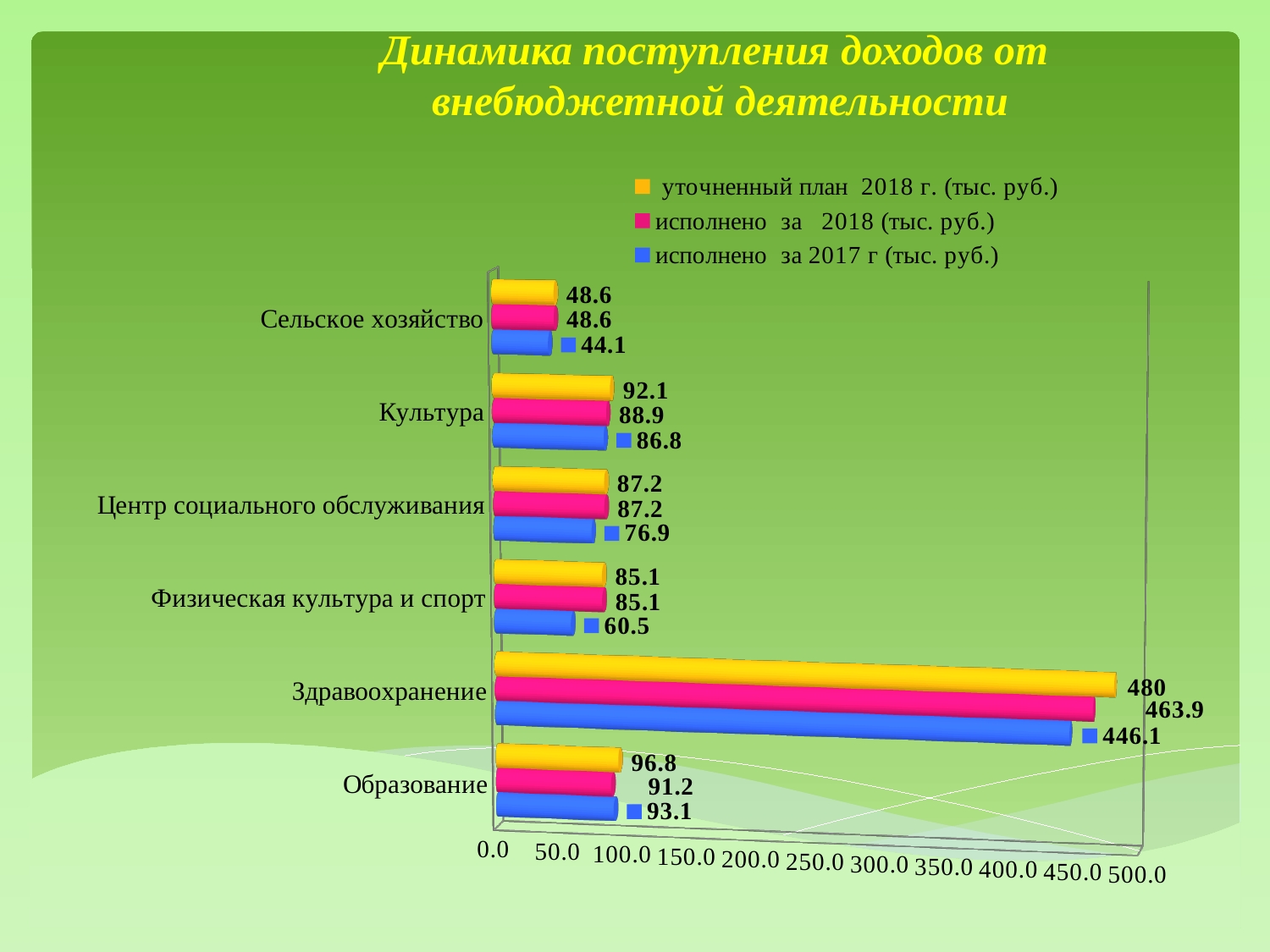
What colour represents the series 'исполнено за 2017 г (тыс. руб.)'? blue What kind of chart is shown on the slide? bar chart What is the difference between the 'уточненный план 2018 г.' and 'исполнено за 2018' values for Здравоохранение? 16.1 How many categories are shown on the chart? 6 Which category has the lowest value in the series 'исполнено за 2017 г (тыс. руб.)'? Сельское хозяйство How many series does the legend list? 3 What is the value for Культура in the series 'исполнено за 2018 (тыс. руб.)'? 88.9 What is the value for Образование in the series 'исполнено за 2017 г (тыс. руб.)'? 93.1 Is the 'исполнено за 2017 г' value for Здравоохранение greater or less than 400.0? greater Which is larger for Физическая культура и спорт: the 'исполнено за 2018' value or the 'исполнено за 2017 г' value? исполнено за 2018 (тыс. руб.) What is the value for Здравоохранение in the series 'уточненный план 2018 г. (тыс. руб.)'? 480 Which category has the highest value in the series 'исполнено за 2018 (тыс. руб.)'? Здравоохранение